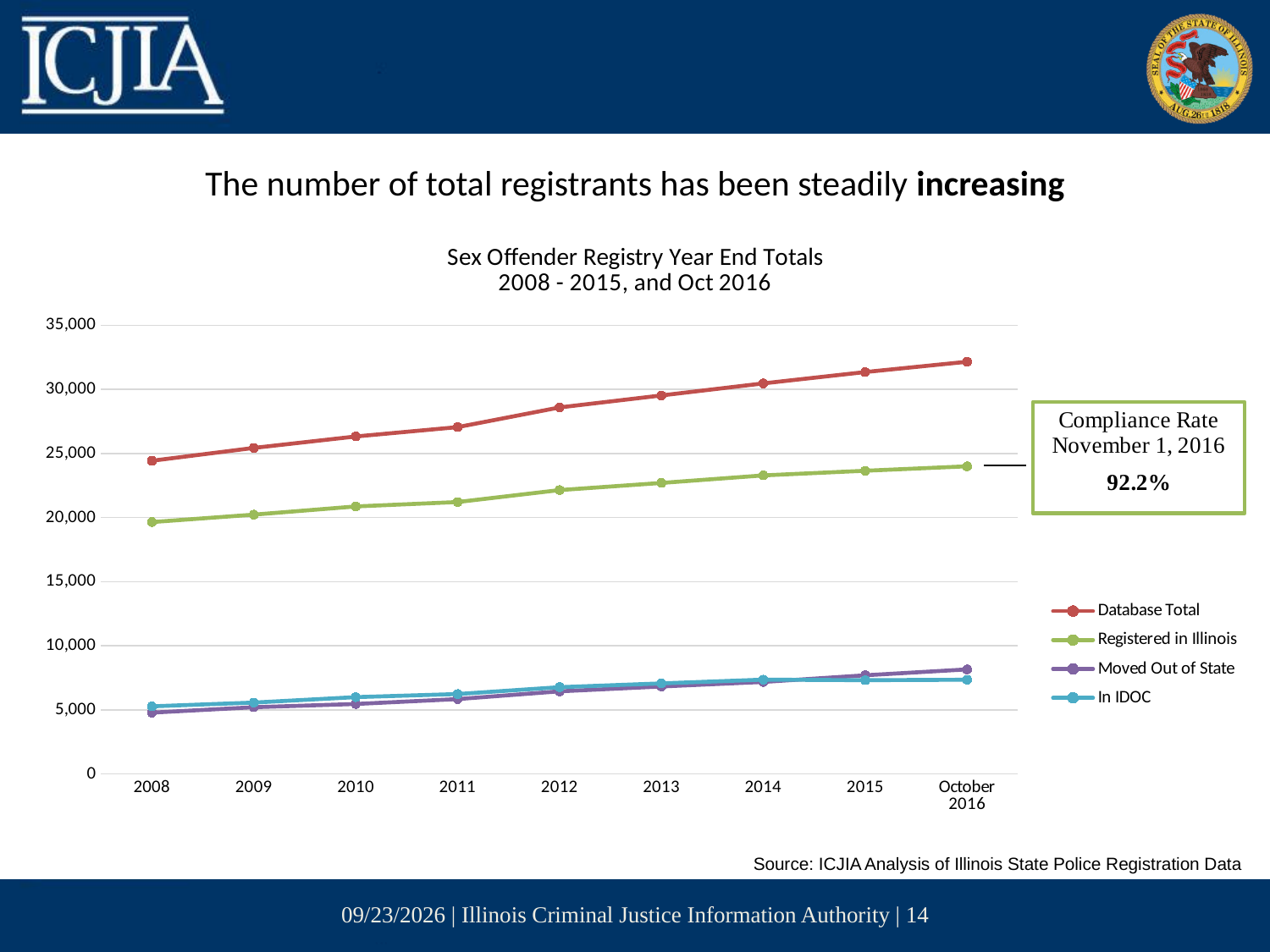
Does the Database Total series rise or fall from 2008 to October 2016? rises What kind of chart is shown on the slide? line chart Is the Database Total value for October 2016 greater or less than 30,000? greater In October 2016, which is larger: Moved Out of State or In IDOC? Moved Out of State How many time points are plotted along the x axis of the chart? 9 Is the Registered in Illinois value for 2015 greater or less than 20,000? greater What compliance rate is shown in the box next to the chart for November 1, 2016? 92.2% Is the Moved Out of State value for October 2016 greater or less than 10,000? less Which series has the highest value in 2015? Database Total How many series does the chart legend list? 4 What is the title of the chart? Sex Offender Registry Year End Totals 2008 - 2015, and Oct 2016 Which series has the lowest value in 2008? Moved Out of State